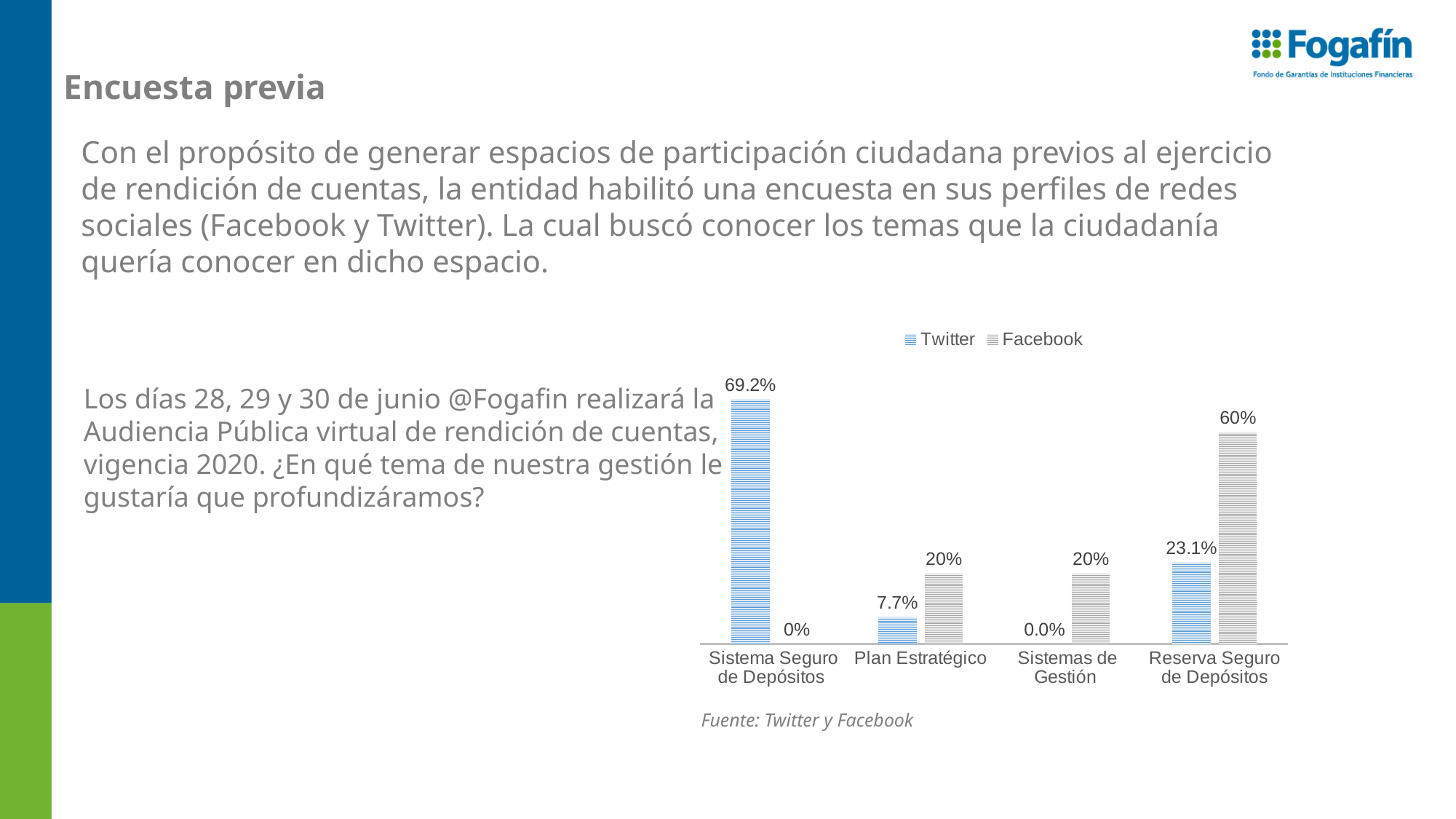
What is the Facebook value for Sistema Seguro de Depósitos? 0% What is the difference between the Twitter values for Sistema Seguro de Depósitos and Reserva Seguro de Depósitos? 46.1% Which category has the highest Facebook value? Reserva Seguro de Depósitos What is the Twitter value for Sistema Seguro de Depósitos? 69.2% What kind of chart is shown on the slide? Bar chart How many categories are shown on the x axis of the chart? 4 What is the Twitter value for Plan Estratégico? 7.7% Which category has the highest Twitter value? Sistema Seguro de Depósitos What is the Facebook value for Reserva Seguro de Depósitos? 60% What is the Twitter value for Sistemas de Gestión? 0.0% How many series does the chart legend list? 2 For Reserva Seguro de Depósitos, which is larger, the Twitter value or the Facebook value? Facebook